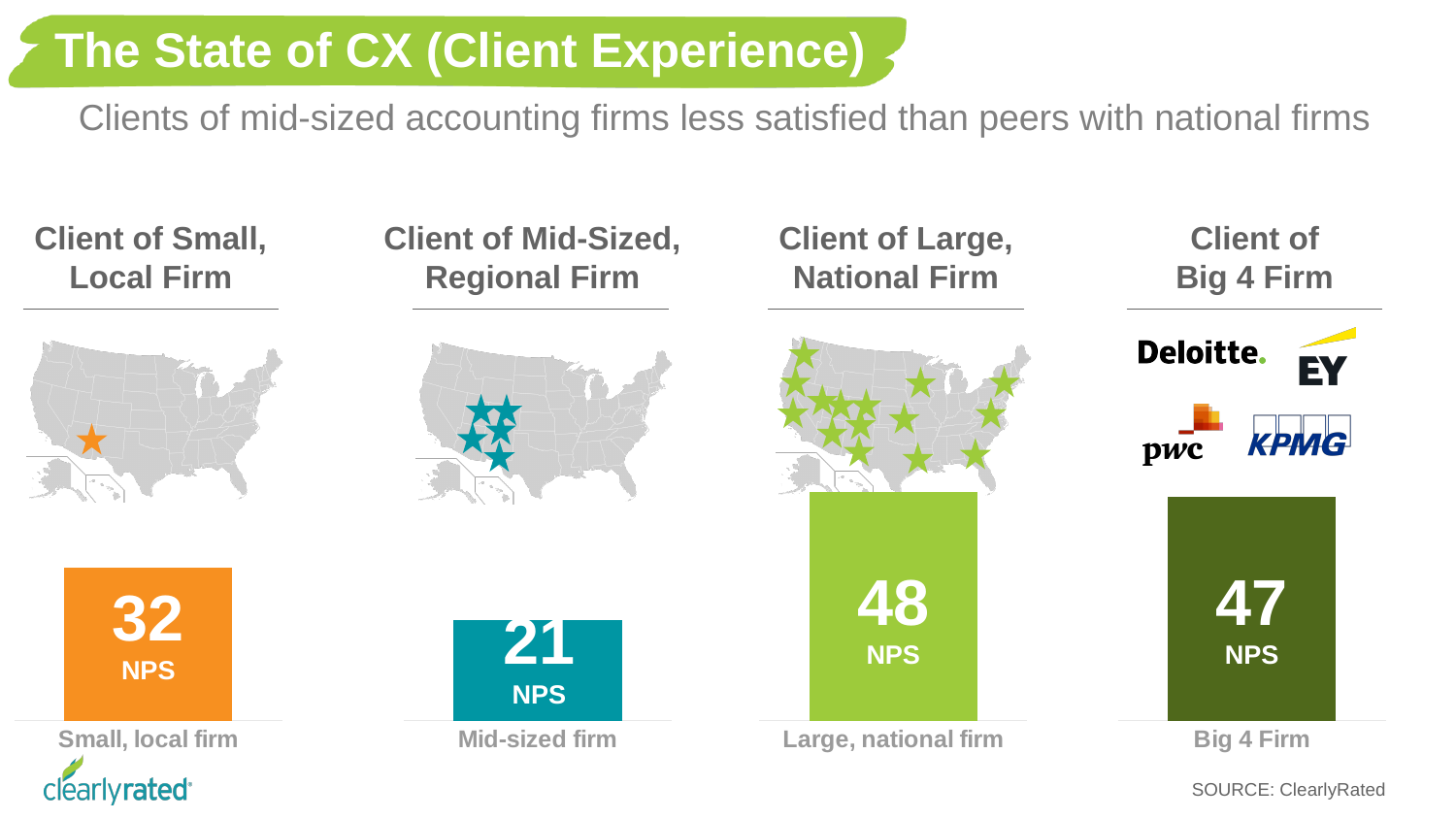
What kind of chart is shown on the slide? Bar chart What is the NPS for clients of a Big 4 firm? 47 What is the difference in NPS between the small, local firm and the mid-sized firm? 11 Which has a higher NPS: the small, local firm or the mid-sized firm? Small, local firm What is the NPS for clients of a mid-sized firm? 21 What is the source cited for the chart data? ClearlyRated Which firm type has the highest NPS? Large, national firm What is the NPS for clients of a small, local firm? 32 What is the NPS for clients of a large, national firm? 48 What is the difference in NPS between the large, national firm and the mid-sized firm? 27 How many firm types are shown in the chart? 4 Which firm type has the lowest NPS? Mid-sized firm